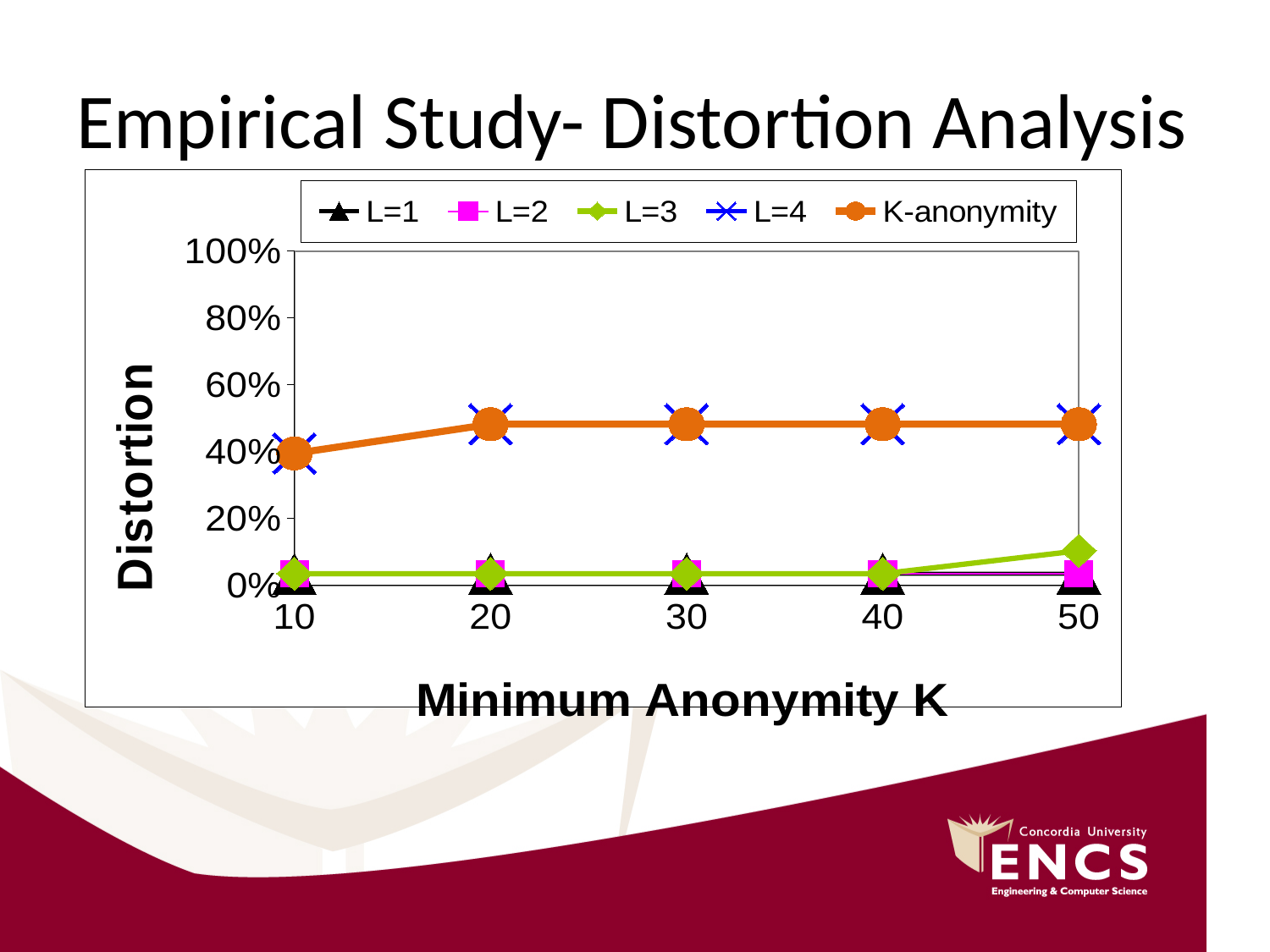
How many series does the legend list? 5 What is the title of the y axis? Distortion Is the distortion for L=1 at K=40 greater or less than 20%? less At K=30, which has the higher distortion: K-anonymity or L=1? K-anonymity For L=3, is the distortion larger at K=40 or at K=50? K=50 What kind of chart is shown on the slide? line chart Is the distortion for K-anonymity at K=30 greater or less than 20%? greater How many values of Minimum Anonymity K are plotted along the x axis? 5 Is the distortion for K-anonymity at K=10 greater or less than 60%? less What is the title of the x axis? Minimum Anonymity K Does the distortion for K-anonymity rise or fall from K=10 to K=20? rise